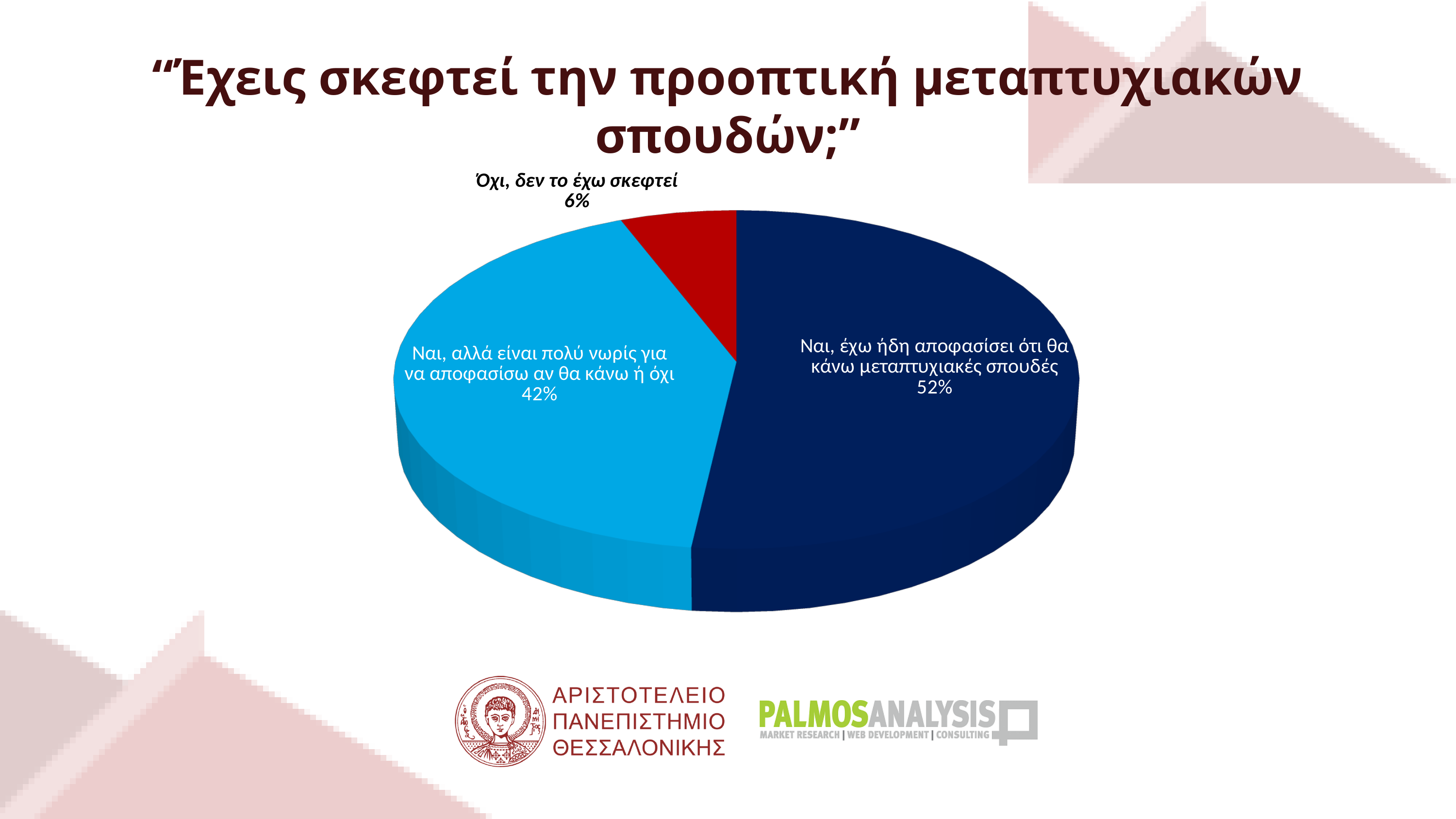
Which category has the smallest slice of the pie? Όχι, δεν το έχω σκεφτεί Which is larger: the "Ναι, έχω ήδη αποφασίσει" slice or the "Ναι, αλλά είναι πολύ νωρίς" slice? Ναι, έχω ήδη αποφασίσει ότι θα κάνω μεταπτυχιακές σπουδές How many slices does the pie chart have? 3 What is the difference in percentage points between the "Ναι, έχω ήδη αποφασίσει" slice and the "Ναι, αλλά είναι πολύ νωρίς" slice? 10% What is the title of the slide above the chart? "Έχεις σκεφτεί την προοπτική μεταπτυχιακών σπουδών;" What colour is the slice labelled "Όχι, δεν το έχω σκεφτεί"? Red What share of the pie is labelled "Όχι, δεν το έχω σκεφτεί"? 6% Which category has the largest slice of the pie? Ναι, έχω ήδη αποφασίσει ότι θα κάνω μεταπτυχιακές σπουδές What share of the pie is labelled "Ναι, έχω ήδη αποφασίσει ότι θα κάνω μεταπτυχιακές σπουδές"? 52% What share of the pie is labelled "Ναι, αλλά είναι πολύ νωρίς για να αποφασίσω αν θα κάνω ή όχι"? 42% What is the difference in percentage points between the "Ναι, αλλά είναι πολύ νωρίς" slice and the "Όχι, δεν το έχω σκεφτεί" slice? 36% What kind of chart is shown on the slide? Pie chart